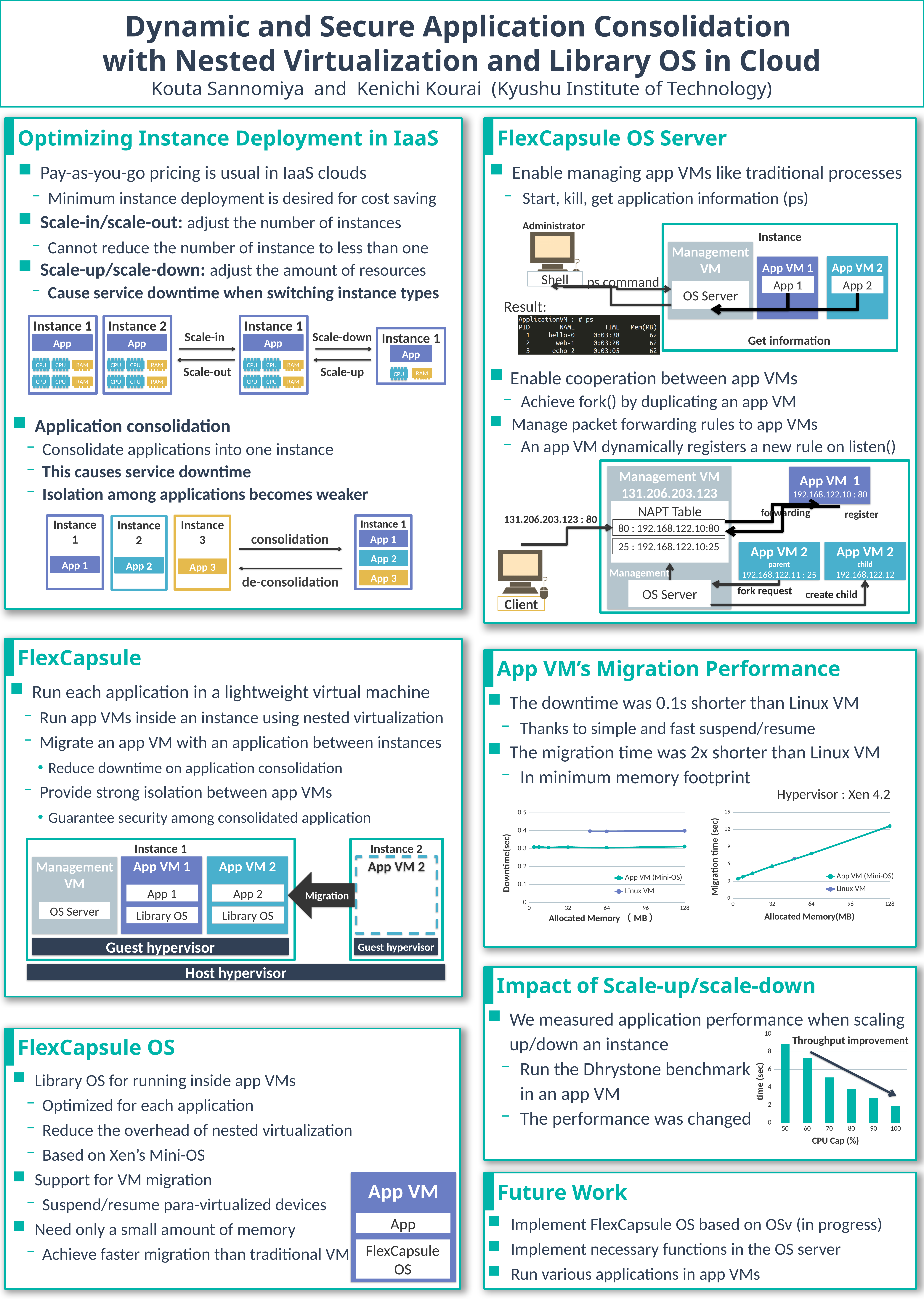
In the 'Throughput improvement' chart, is the time for CPU Cap 50 greater or less than 8? greater In the 'Throughput improvement' chart, which has a larger time, CPU Cap 60 or CPU Cap 80? CPU Cap 60 In the 'Throughput improvement' chart, how many CPU Cap categories are plotted? 6 In the 'Throughput improvement' chart, is the time for CPU Cap 90 greater or less than 4? less In the 'Throughput improvement' chart, which CPU Cap (%) has the lowest time? 100 In the Downtime chart (left chart under App VM's Migration Performance), is the Linux VM downtime at 64 MB greater or less than 0.3? greater In the 'Throughput improvement' chart, does the time rise or fall as CPU Cap increases from 50 to 100? fall In the 'Throughput improvement' chart, what kind of chart is it? bar chart In the Migration time chart (right chart under App VM's Migration Performance), does the App VM (Mini-OS) migration time rise or fall as allocated memory increases? rise In the 'Throughput improvement' chart, which CPU Cap (%) has the highest time? 50 In the Downtime chart (left chart under App VM's Migration Performance), how many series does the legend list? 2 In the Downtime chart (left chart under App VM's Migration Performance), which series has the higher downtime, App VM (Mini-OS) or Linux VM? Linux VM